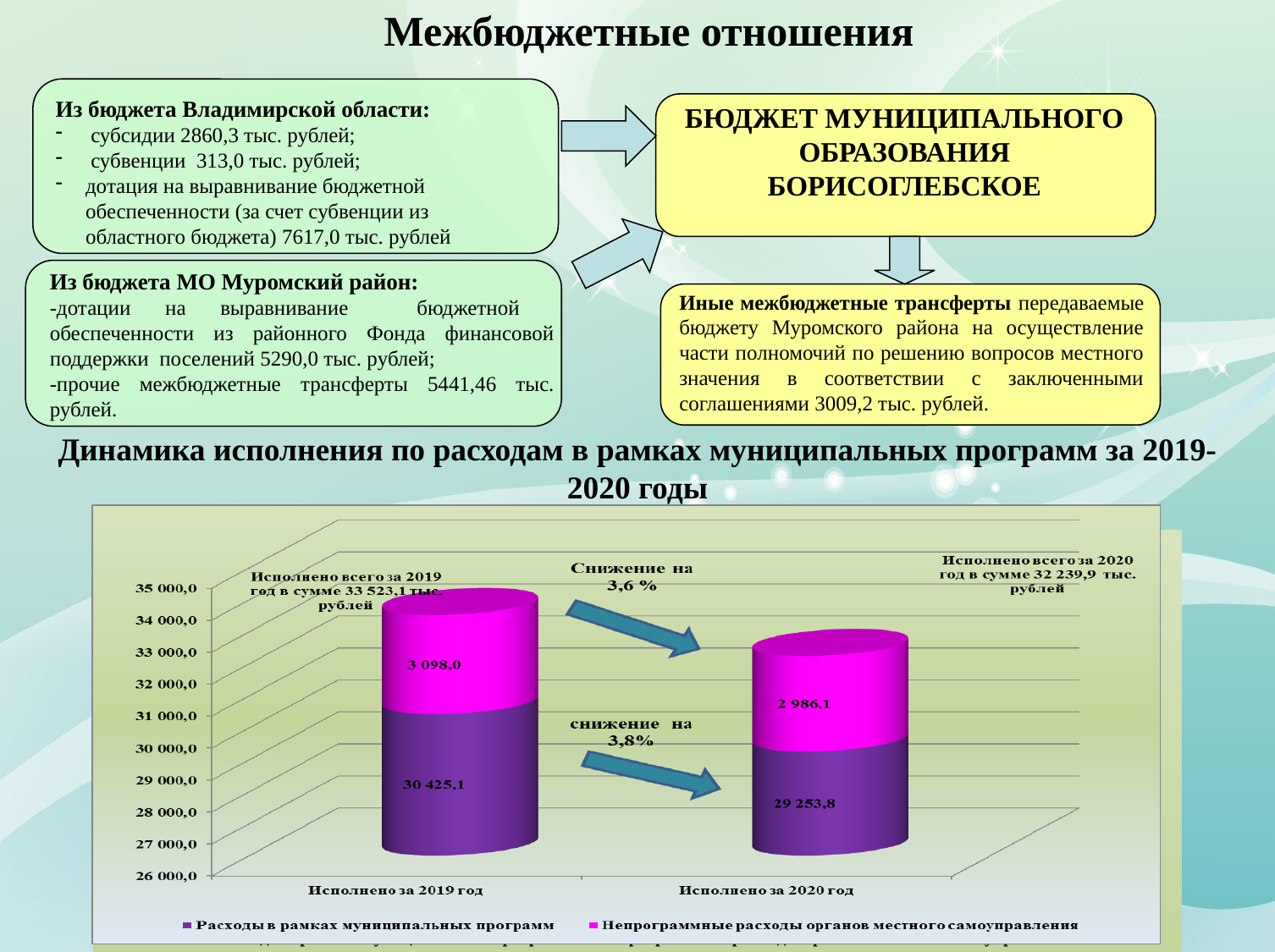
How many categories are shown on the x axis of the chart? 2 How many series does the chart legend list? 2 By how much did 'Расходы в рамках муниципальных программ' decrease from 2019 to 2020? 1 171,3 What is the total executed amount for 2019 according to the annotation on the chart? 33 523,1 тыс. рублей What value is shown for 'Непрограммные расходы органов местного самоуправления' in 'Исполнено за 2020 год'? 2 986,1 What value is shown for 'Расходы в рамках муниципальных программ' in 'Исполнено за 2020 год'? 29 253,8 What percentage decrease is annotated for 'Расходы в рамках муниципальных программ' between 2019 and 2020? 3,8% Which year has the larger value for 'Непрограммные расходы органов местного самоуправления', 2019 or 2020? Исполнено за 2019 год What value is shown for 'Непрограммные расходы органов местного самоуправления' in 'Исполнено за 2019 год'? 3 098,0 What value is shown for 'Расходы в рамках муниципальных программ' in 'Исполнено за 2019 год'? 30 425,1 What kind of chart is shown on the slide? Stacked bar chart What is the total executed amount for 2020 according to the annotation on the chart? 32 239,9 тыс. рублей